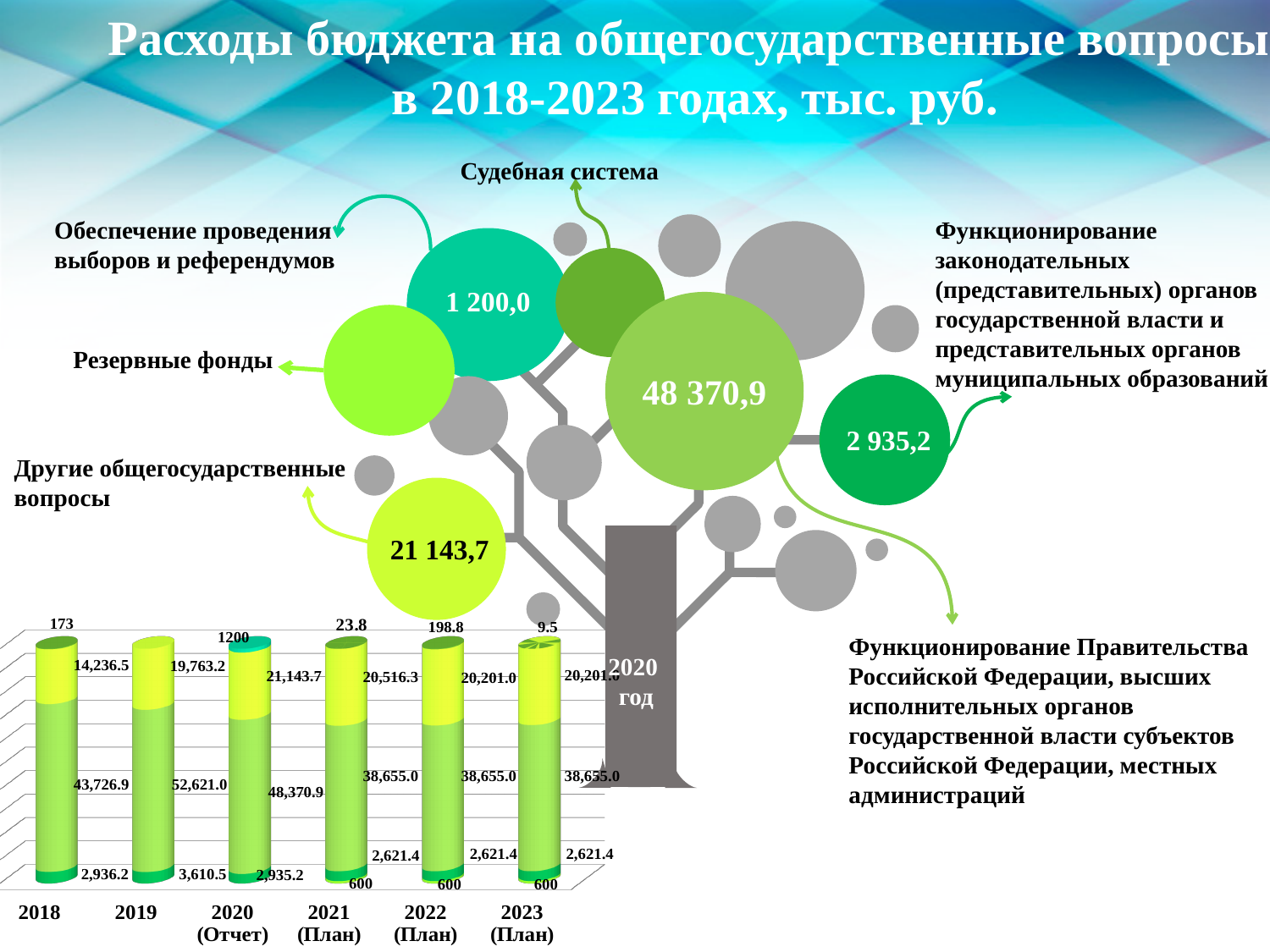
In the bar chart, what is the value of the largest (middle) segment of the 2019 bar? 52,621.0 What kind of chart is shown at the bottom left of the slide? Stacked bar chart In the bar chart, what is the value of the largest (middle) segment of the 2020 (Отчет) bar? 48,370.9 In the bar chart, what is the difference between the middle-segment values for 2019 and 2018? 8,894.1 In the bar chart, which year has the highest value for the largest (middle) segment? 2019 In the tree diagram, what value is shown for Функционирование законодательных (представительных) органов государственной власти? 2 935,2 In the bar chart, what is the value labelled at the bottom of the 2018 bar? 2,936.2 In the bar chart, which is larger: the middle-segment value for 2020 (Отчет) or for 2021 (План)? 2020 (Отчет) In the tree diagram, what value is shown for Другие общегосударственные вопросы? 21 143,7 How many years (categories) are shown on the x axis of the bar chart? 6 In the bar chart, what is the value of the upper yellow-green segment of the 2021 (План) bar? 20,516.3 In the bar chart, how does the middle-segment value change from 2021 (План) to 2023 (План)? It stays the same at 38,655.0